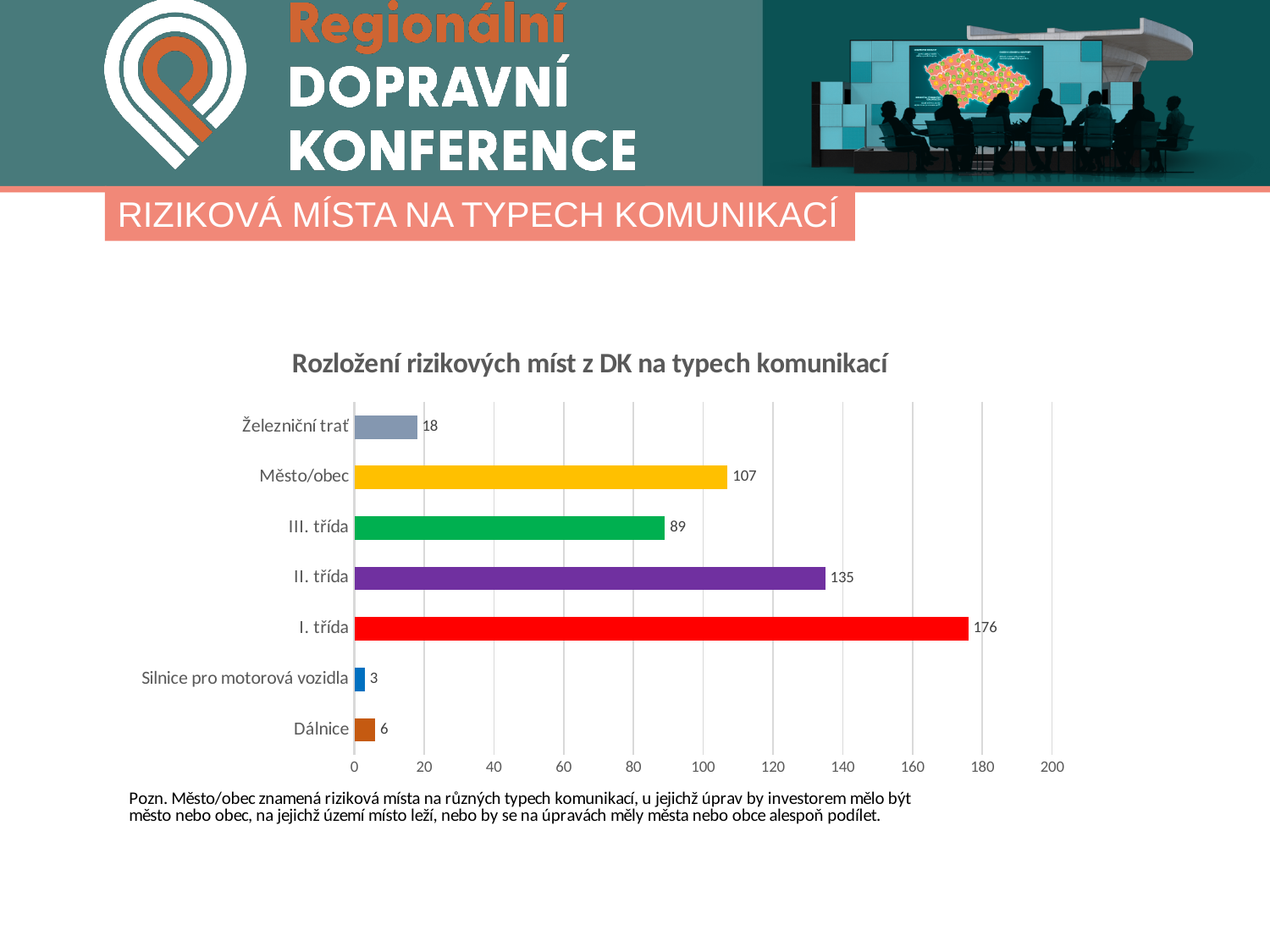
Which category has the highest value? I. třída Is the value for III. třída greater or less than 100? less What is the title of the chart? Rozložení rizikových míst z DK na typech komunikací Which is larger, the value for II. třída or the value for Město/obec? II. třída What is the value for I. třída? 176 What is the difference between the values for I. třída and II. třída? 41 What is the difference between the values for Město/obec and III. třída? 18 How many categories are shown in the chart? 7 What kind of chart is shown on the slide? bar chart What is the value for Město/obec? 107 Which category has the lowest value? Silnice pro motorová vozidla What is the value for Železniční trať? 18